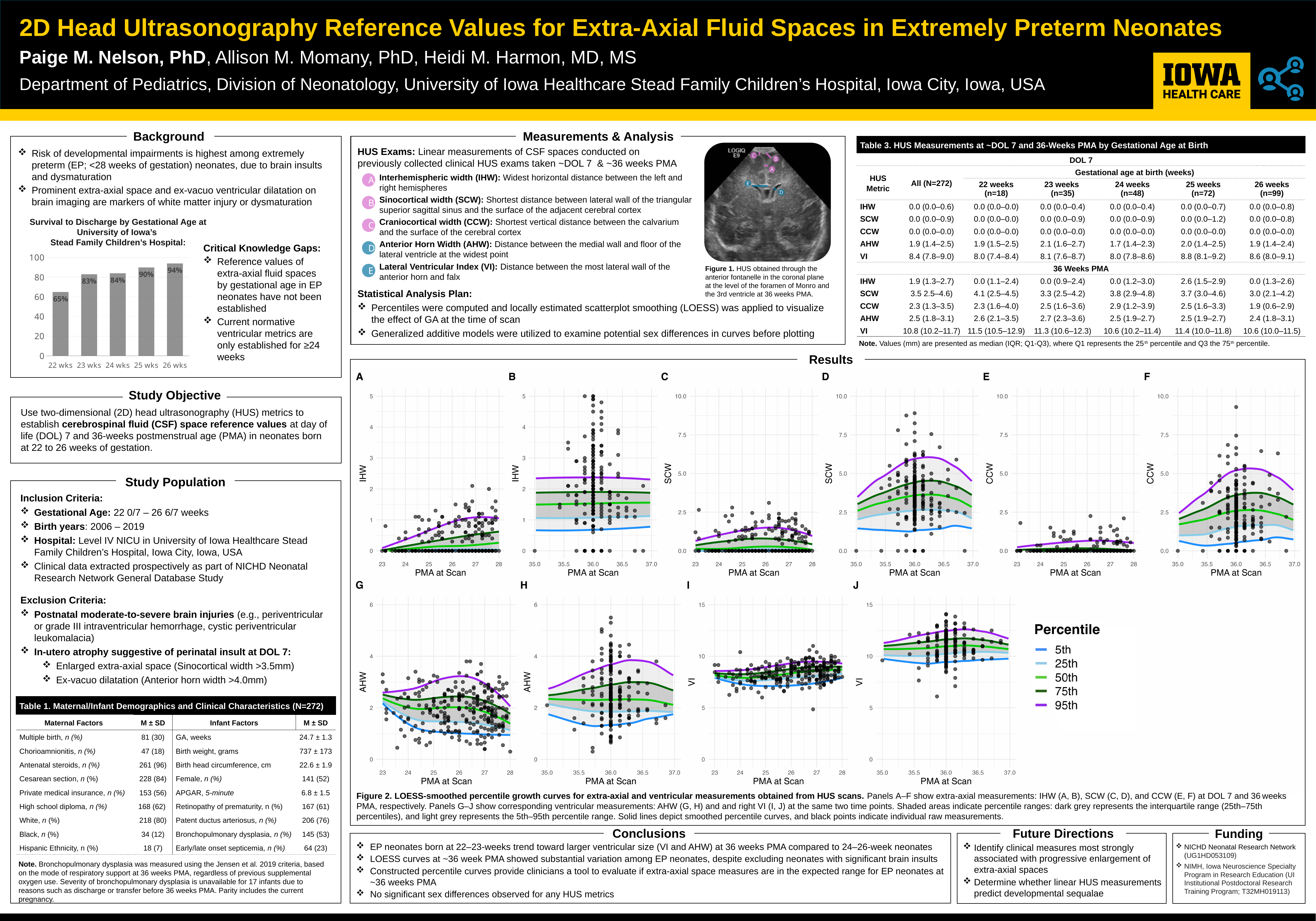
In the 'Survival to Discharge by Gestational Age' chart, which is larger, the value for 25 wks or the value for 23 wks? 25 wks In the 'Survival to Discharge by Gestational Age' chart, what is the survival value for 22 wks? 65% In the 'Survival to Discharge by Gestational Age' chart, how many gestational age categories are shown? 5 In the 'Survival to Discharge by Gestational Age' chart, what is the difference between the survival values for 23 wks and 22 wks? 18% In the 'Survival to Discharge by Gestational Age' chart, which gestational age category has the lowest survival? 22 wks In the 'Survival to Discharge by Gestational Age' chart, which gestational age category has the highest survival? 26 wks What kind of chart is the 'Survival to Discharge by Gestational Age' chart? bar chart In the 'Survival to Discharge by Gestational Age' chart, what is the survival value for 24 wks? 84% In the 'Survival to Discharge by Gestational Age' chart, do the survival values rise or fall as gestational age increases from 22 wks to 26 wks? rise In the Results figure (Figure 2), how many percentile curves does the 'Percentile' legend list? 5 In the 'Survival to Discharge by Gestational Age' chart, what is the difference between the survival values for 26 wks and 22 wks? 29% In the 'Survival to Discharge by Gestational Age' chart, what is the survival value for 25 wks? 90%